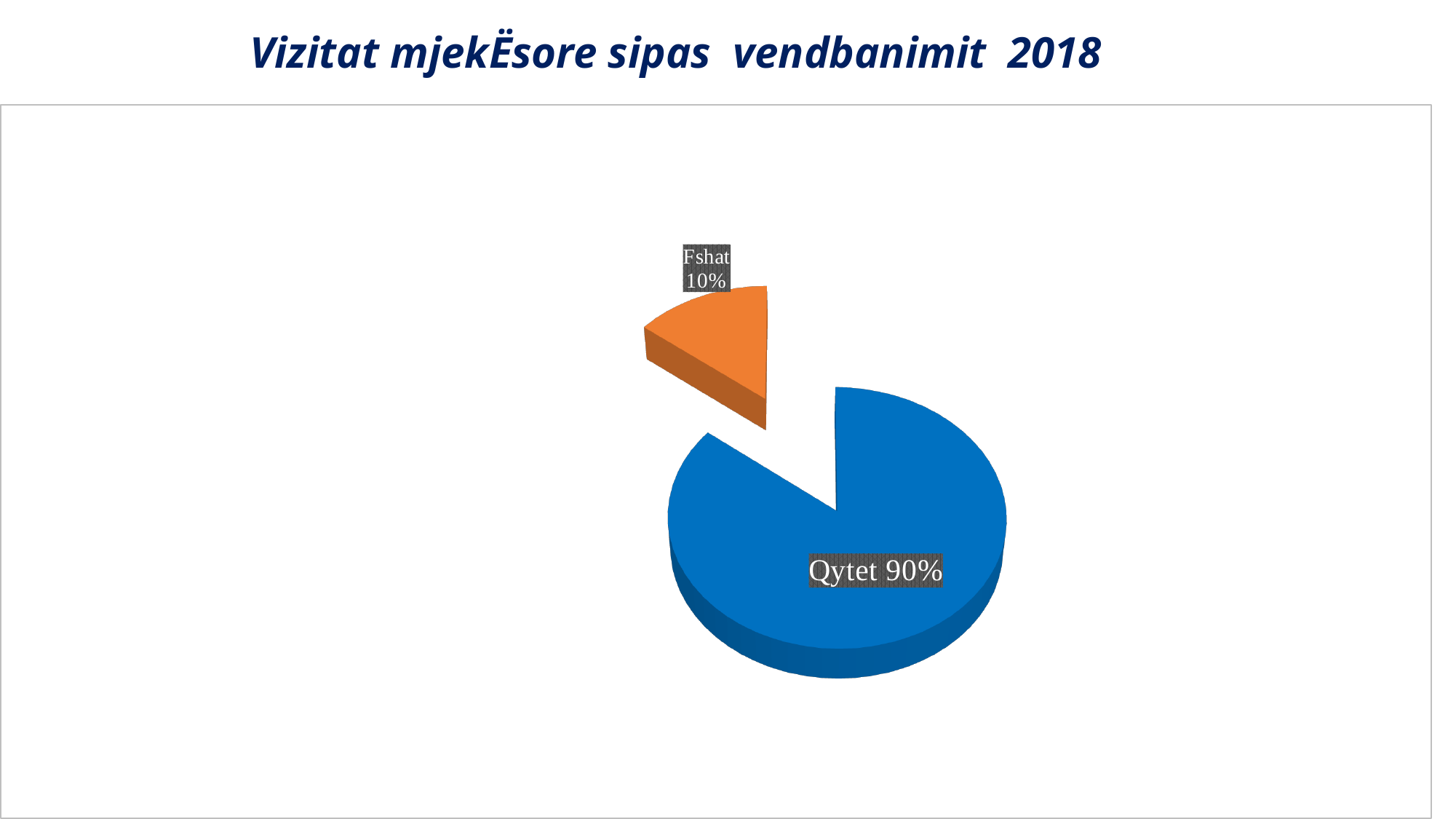
What is the difference in percentage points between the Qytet and Fshat slices? 80 What colour is the Fshat slice? Orange Which is larger, the Qytet slice or the Fshat slice? Qytet What share of the pie does Qytet represent? 90% What kind of chart is shown on the slide? Pie chart What is the title of the slide? Vizitat mjekËsore sipas vendbanimit 2018 Which category has the smallest slice of the pie? Fshat How many slices does the pie chart have? 2 What share of the pie does Fshat represent? 10% Which category has the largest slice of the pie? Qytet